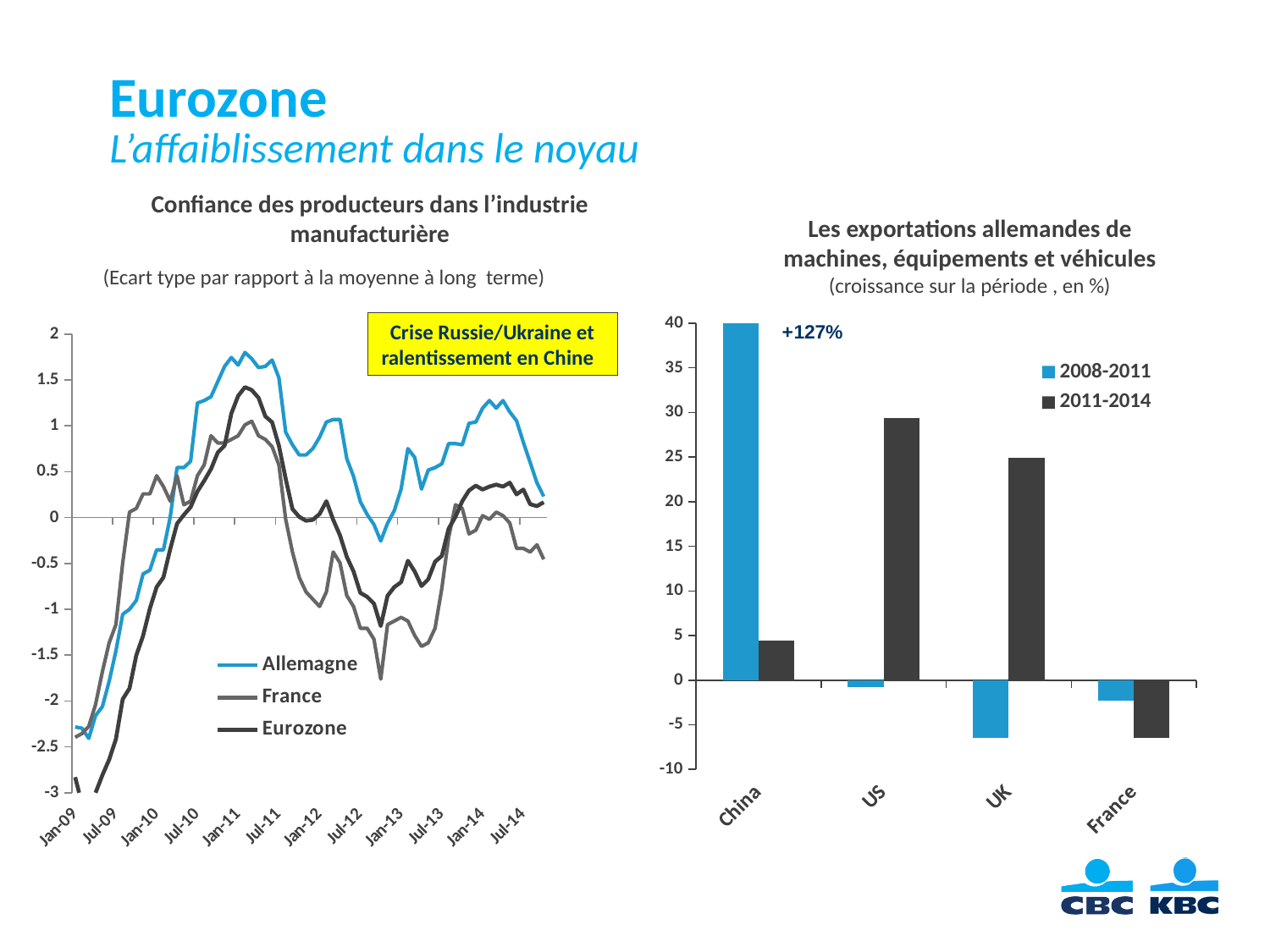
In the right chart on German exports, is the 2008-2011 value for UK greater or less than -5? less What kind of chart is the chart on the left, 'Confiance des producteurs dans l'industrie manufacturière'? line chart In the left chart on producer confidence, which series reaches the highest peak around Jan-11? Allemagne In the right chart on German exports, how many countries are shown on the x axis? 4 In the right chart on German exports, which is larger for 2011-2014: UK or France? UK What kind of chart is the chart on the right, 'Les exportations allemandes de machines, équipements et véhicules'? bar chart In the left chart on producer confidence, how many series does the legend list? 3 In the right chart on German exports, how many series does the legend list? 2 In the right chart on German exports, is the 2011-2014 value for US greater or less than 25? greater In the left chart on producer confidence, what are the three series listed in the legend? Allemagne, France, Eurozone In the right chart on German exports, what growth value is printed for China for 2008-2011? +127% In the right chart on German exports, which country has the highest value for 2011-2014? US